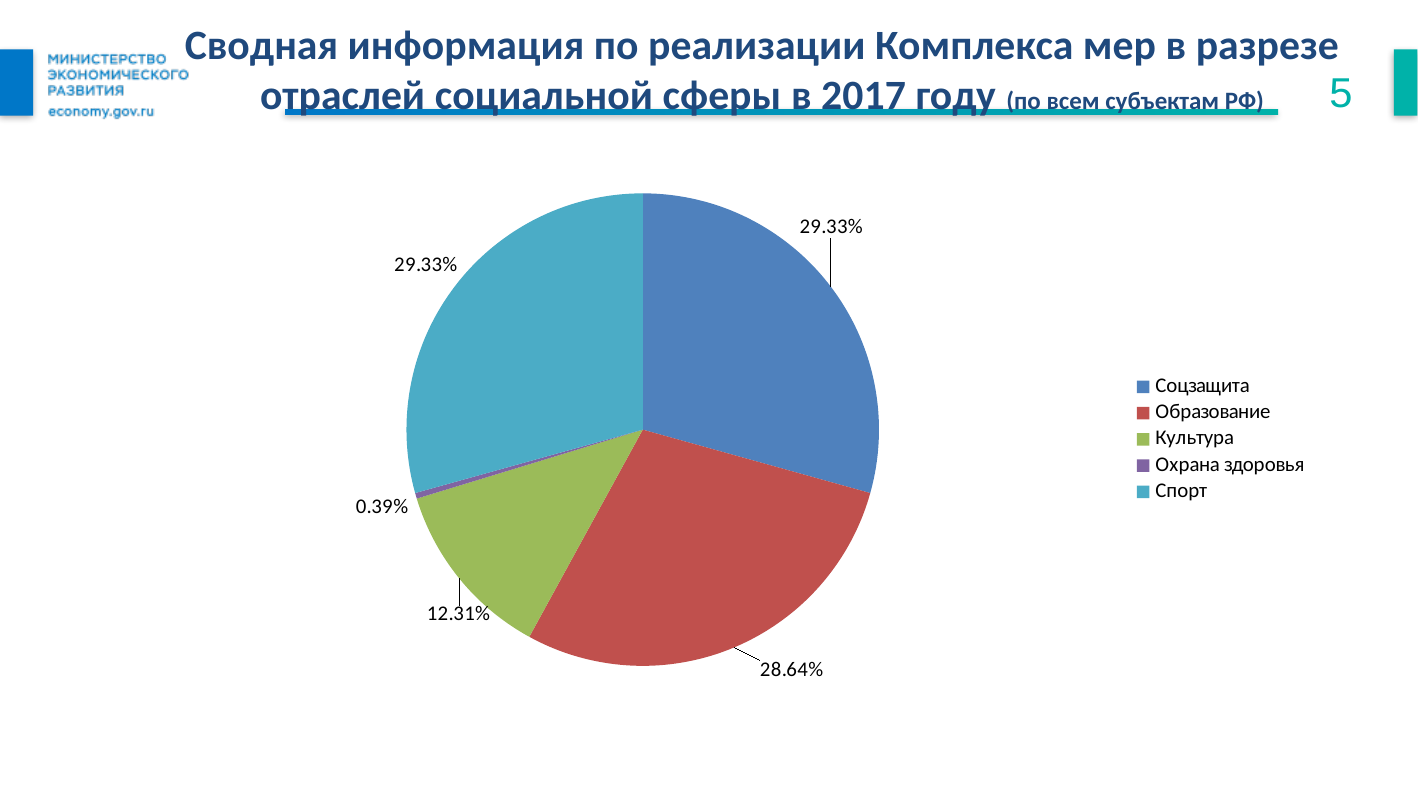
What share of the pie does Спорт have? 29.33% Which is larger, the share for Образование or the share for Культура? Образование Which category has the smallest slice of the pie? Охрана здоровья How many categories does the pie chart have? 5 What kind of chart is shown on the slide? pie chart What is the difference between the shares for Образование and Культура? 16.33% What share of the pie does Охрана здоровья have? 0.39% What share of the pie does Образование have? 28.64% What is the difference between the shares for Соцзащита and Образование? 0.69% Which category is shown in red in the legend? Образование